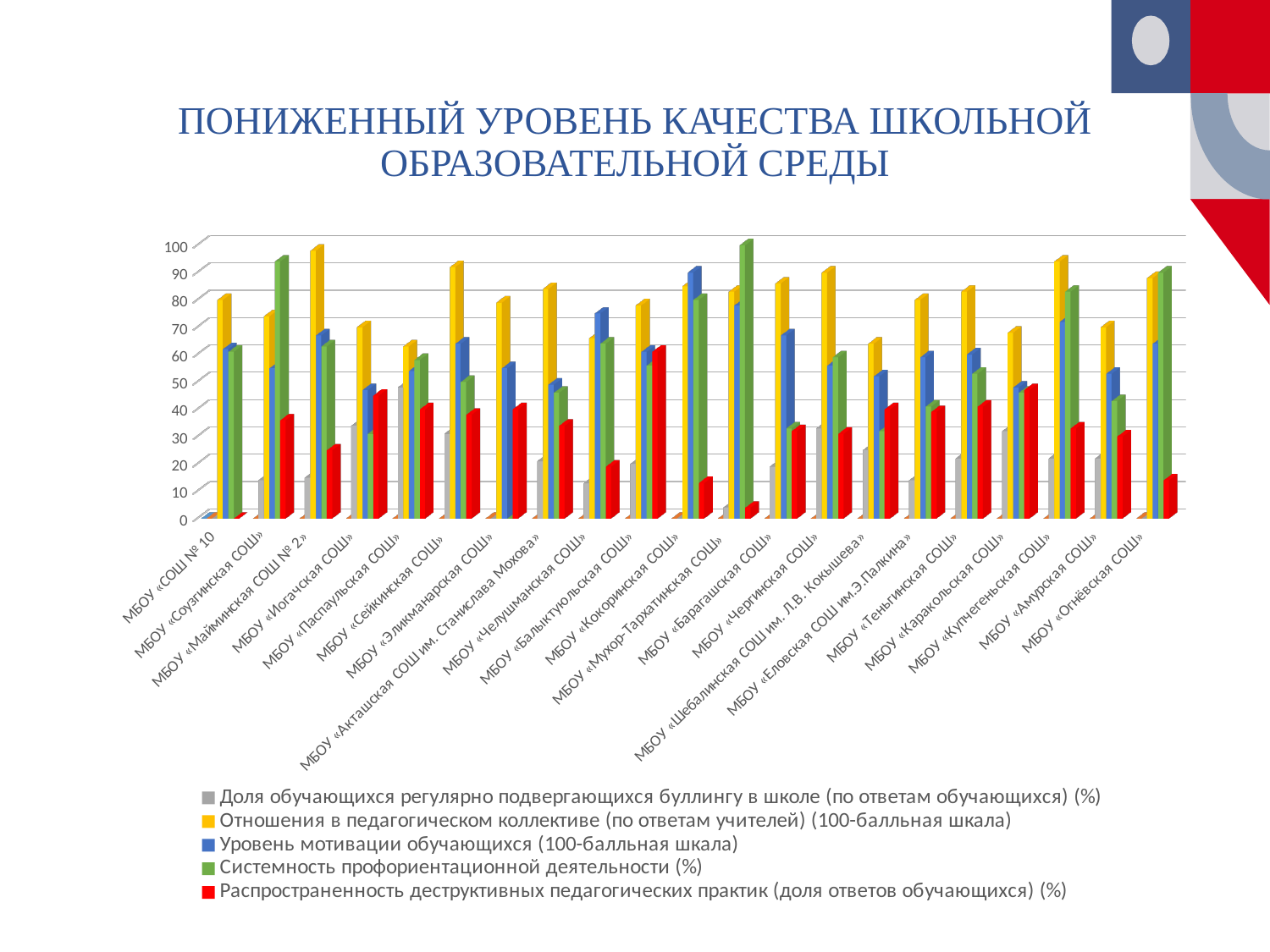
How many schools (categories) are shown on the x axis? 21 Which school has the highest value of «Распространенность деструктивных педагогических практик»? МБОУ «Балыктуюльская СОШ» Is the value of «Распространенность деструктивных педагогических практик» for МБОУ «Кокоринская СОШ» greater or less than 50? less Which school has the highest value of «Уровень мотивации обучающихся»? МБОУ «Кокоринская СОШ» Is the value of «Системность профориентационной деятельности» for МБОУ «Барагашская СОШ» greater or less than 90? less Is the value of «Распространенность деструктивных педагогических практик» for МБОУ «Барагашская СОШ» greater or less than 10? greater Which is larger: «Отношения в педагогическом коллективе» for МБОУ «Майминская СОШ № 2» or for МБОУ «Сейкинская СОШ»? МБОУ «Майминская СОШ № 2» What colour represents «Распространенность деструктивных педагогических практик» in the legend? red Which is larger: «Доля обучающихся регулярно подвергающихся буллингу в школе» for МБОУ «Паспаульская СОШ» or for МБОУ «Соузгинская СОШ»? МБОУ «Паспаульская СОШ» How many series does the legend list? 5 What kind of chart is shown on the slide? bar chart